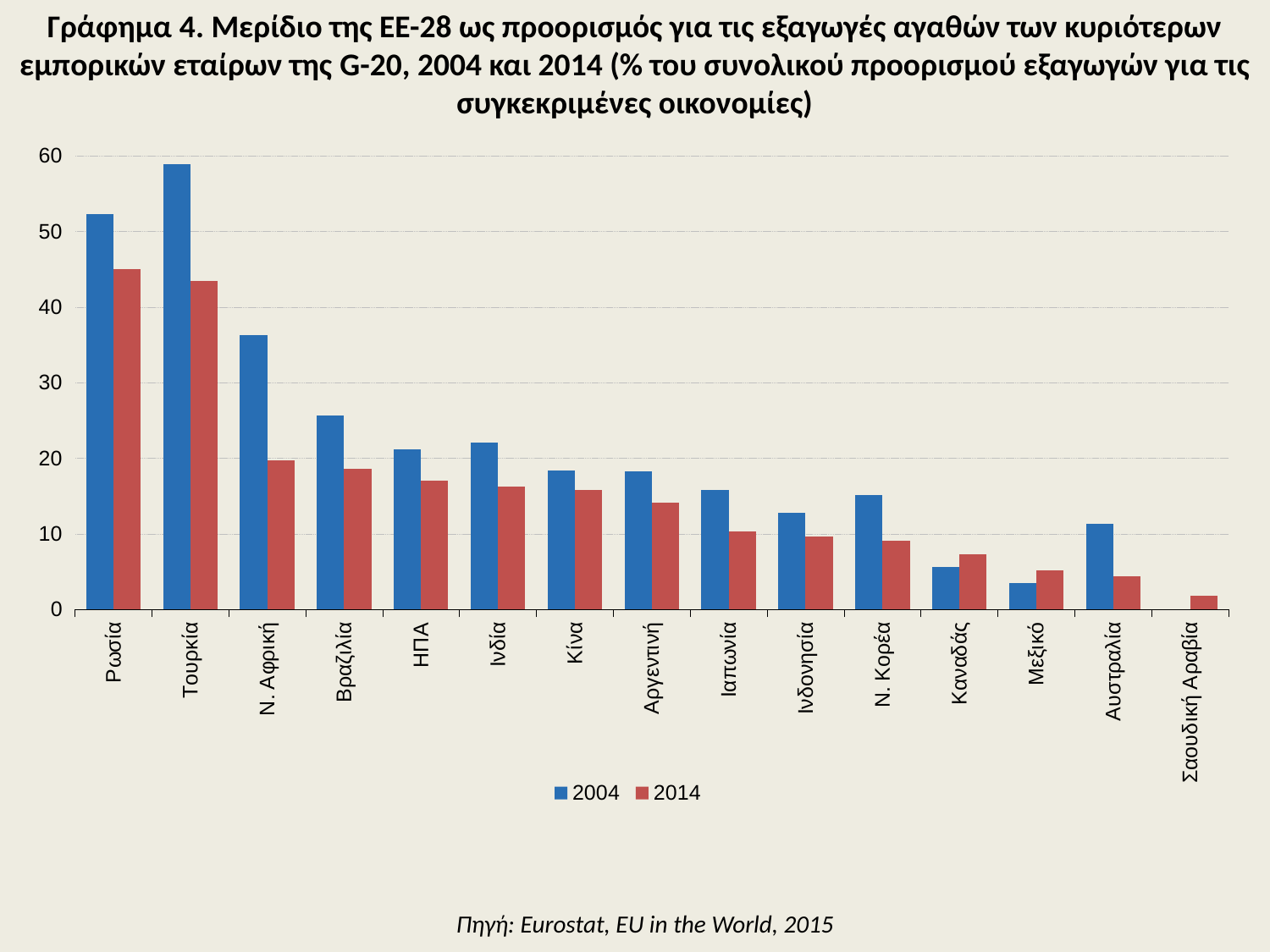
Is the 2014 value for Καναδάς greater or less than 10? less How many countries are shown on the x axis? 15 Which series is shown in blue? 2004 Which country has the highest value for 2004? Τουρκία Which country has the lowest value for 2014? Σαουδική Αραβία What kind of chart is shown on the slide? bar chart Is the 2014 value for Βραζιλία greater or less than 20? less Is the 2004 value for Ρωσία greater or less than 50? greater Which country has the highest value for 2014? Ρωσία For Μεξικό, which year has the larger value, 2004 or 2014? 2014 How many series does the legend list? 2